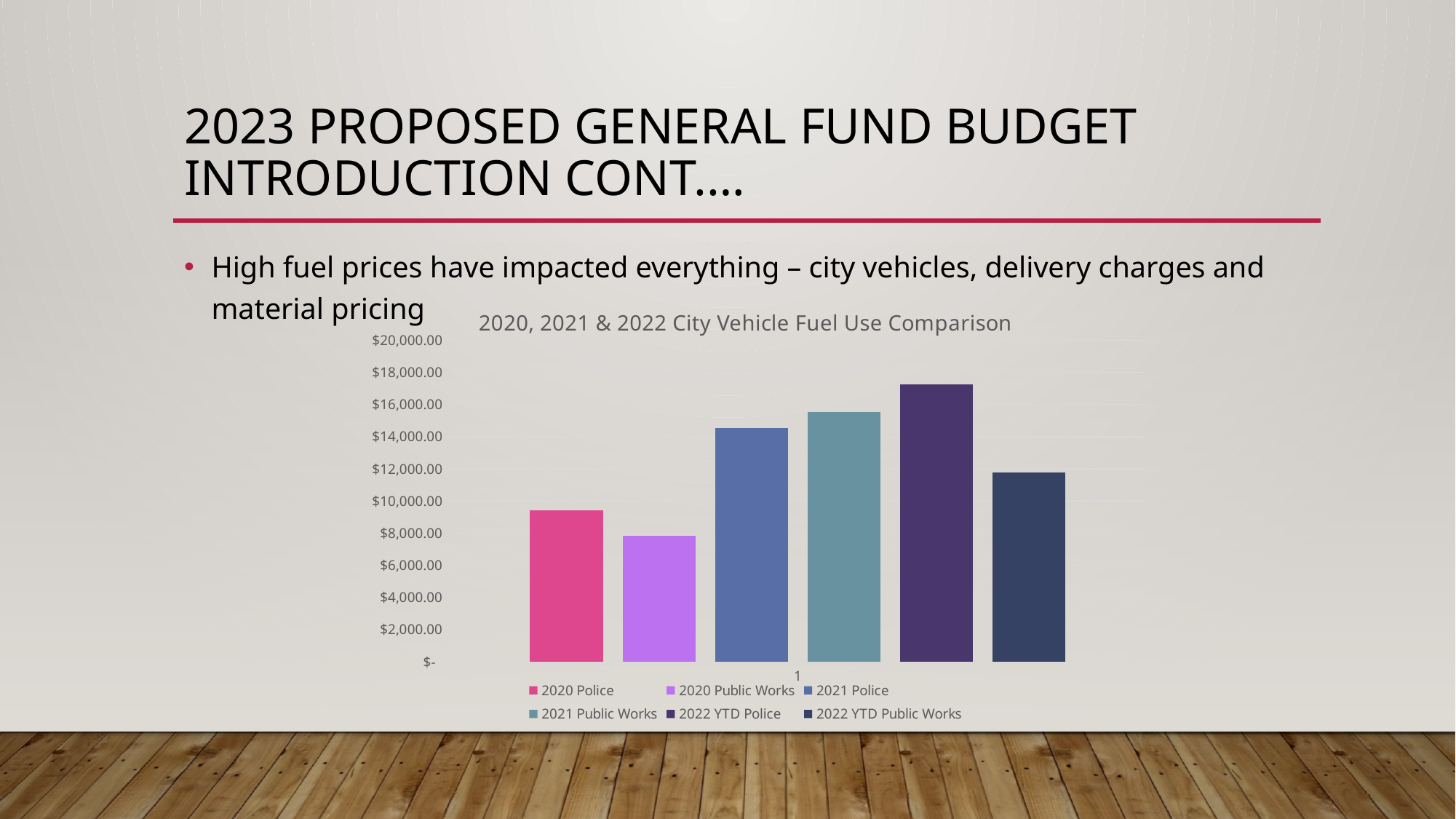
Is the value for 2022 YTD Police greater or less than $16,000.00? greater Which is larger, the value for 2021 Police or the value for 2021 Public Works? 2021 Public Works Which is larger, the value for 2022 YTD Public Works or the value for 2020 Police? 2022 YTD Public Works Which series has the highest bar in the chart? 2022 YTD Police Is the value for 2020 Police greater or less than $10,000.00? less Which series has the lowest bar in the chart? 2020 Public Works How many series does the chart legend list? 6 Is the value for 2022 YTD Public Works greater or less than $10,000.00? greater Do the Police fuel use values rise or fall from 2020 to 2022 YTD? Rise What is the title of the chart? 2020, 2021 & 2022 City Vehicle Fuel Use Comparison What kind of chart is shown on the slide? Bar chart